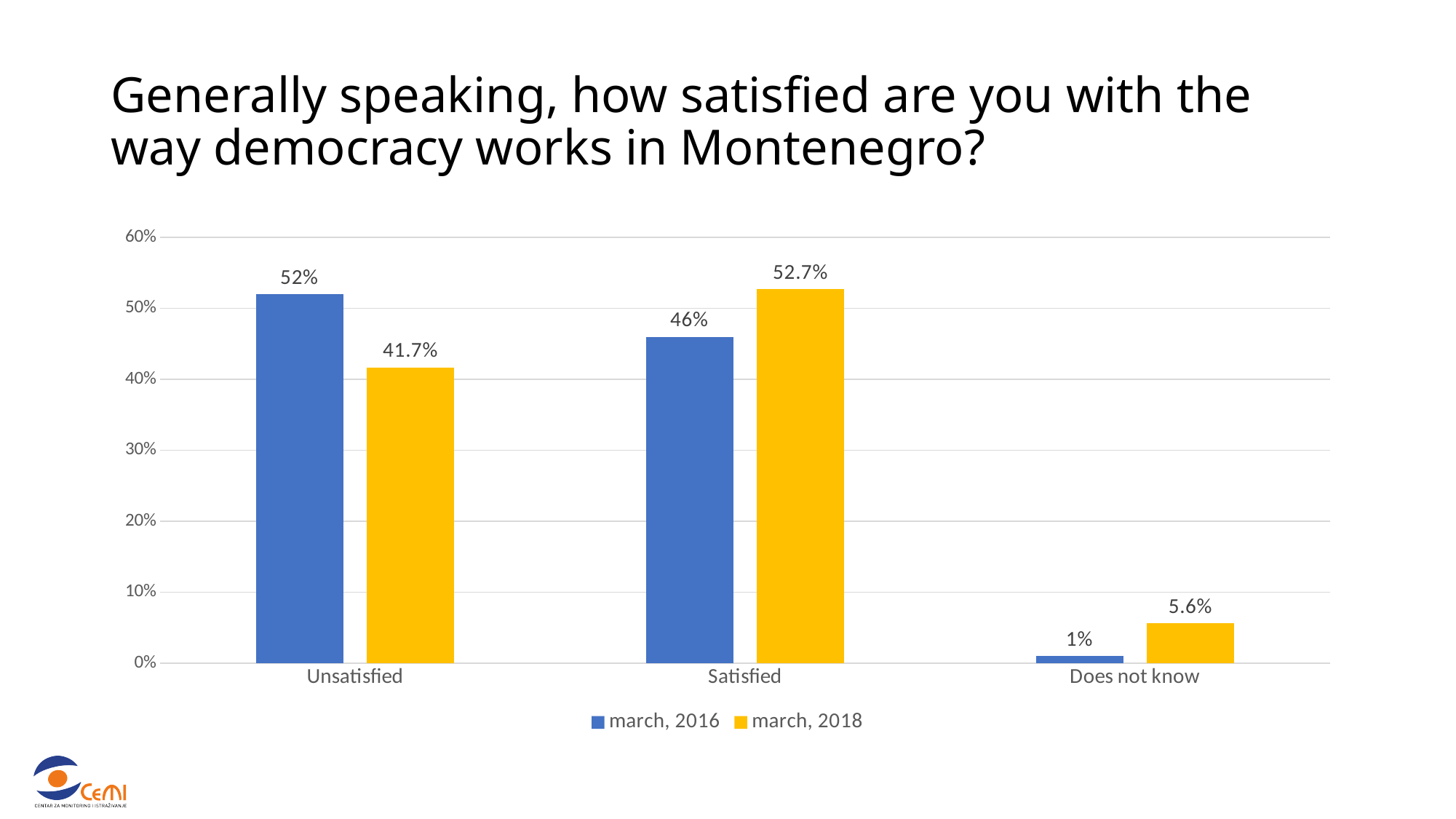
Which category has the highest value in the march, 2018 series? Satisfied What is the value for Does not know in march, 2016? 1% Which colour represents the march, 2018 series? Yellow How many categories are shown on the x axis? 3 What is the value for Satisfied in march, 2018? 52.7% What is the difference between the march, 2016 and march, 2018 values for Unsatisfied? 10.3% What is the value for Unsatisfied in march, 2016? 52% Which category has the lowest value in the march, 2016 series? Does not know What kind of chart is shown on the slide? Bar chart What is the value for Unsatisfied in march, 2018? 41.7% How many series does the legend list? 2 Which is larger for Satisfied: the march, 2016 value or the march, 2018 value? march, 2018